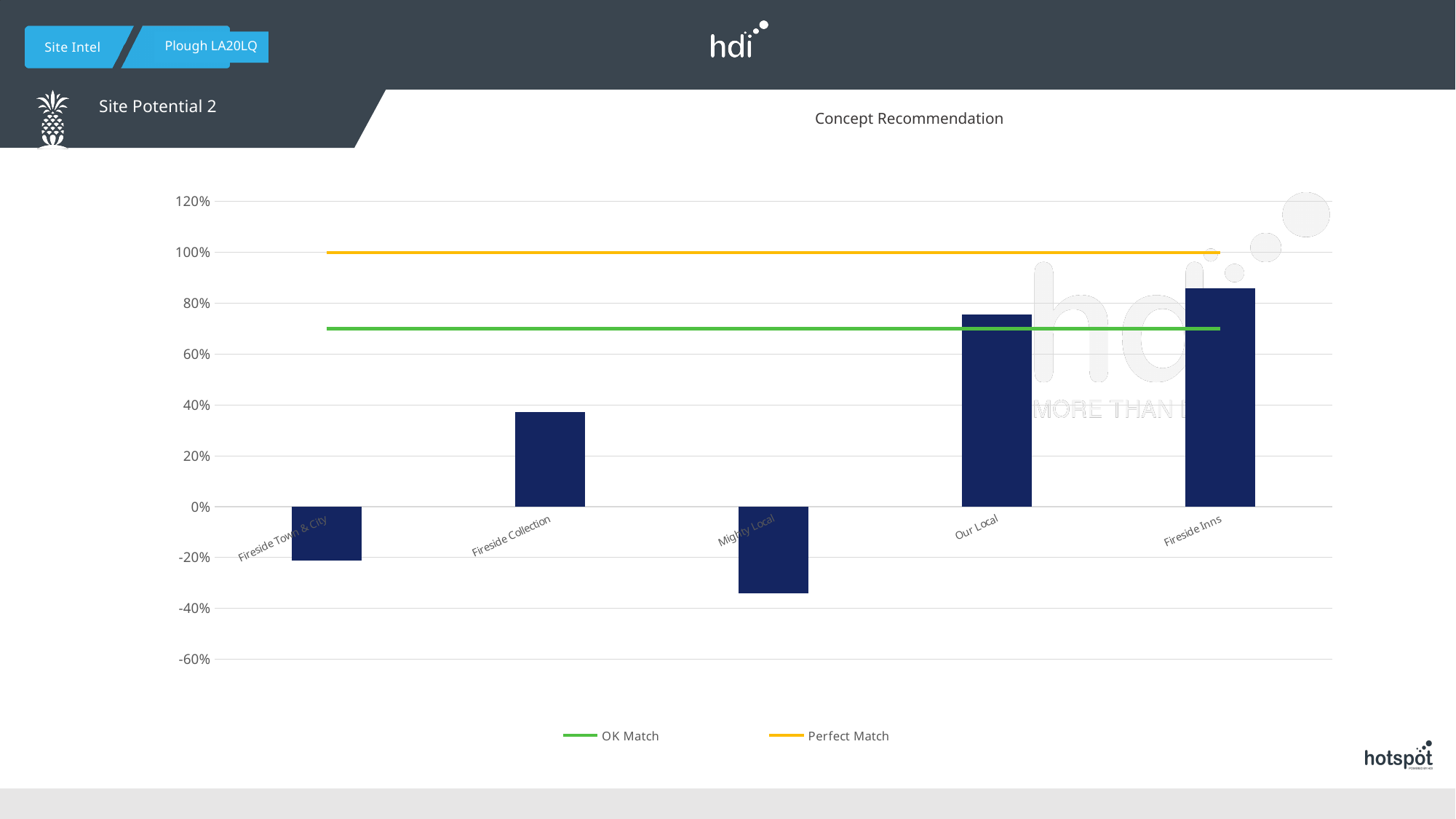
Which concept has the highest bar? Fireside Inns Which is larger, the value for Our Local or the value for Fireside Collection? Our Local Is the value for Fireside Collection greater or less than 20%? greater What colour is the Perfect Match line in the legend? yellow Which concept has the lowest bar? Mighty Local How many entries does the legend list? 2 Is the value for Fireside Inns greater or less than 80%? greater At what level on the y axis is the Perfect Match line drawn? 100% Is the OK Match line above or below 80% on the y axis? below How many concept categories are plotted on the x axis? 5 What kind of chart is shown on the slide? bar chart